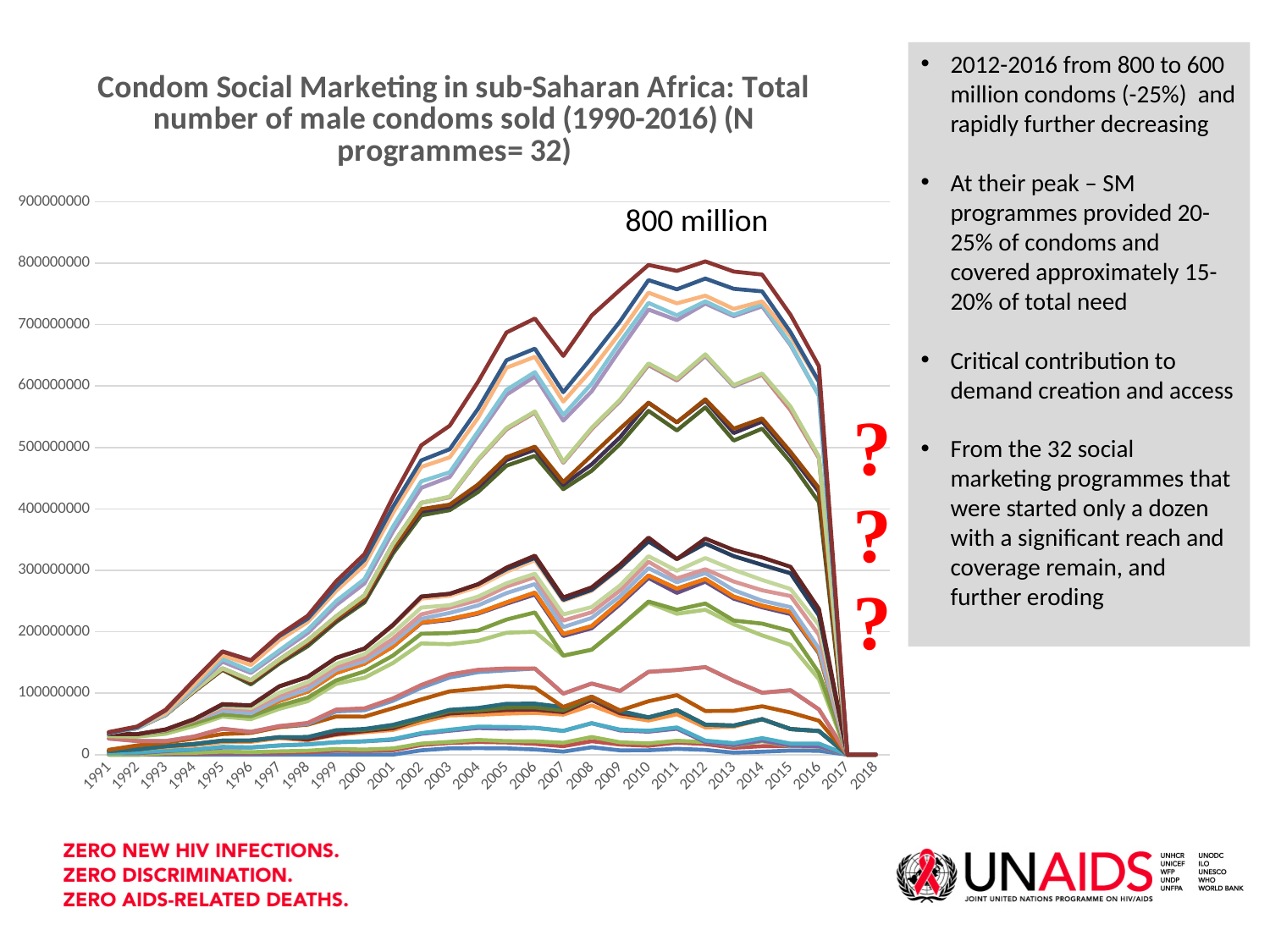
Is the value of the topmost line in 2000 greater or less than 400000000? less What kind of chart is shown on the slide? line chart What is the highest value labelled on the y axis of the chart? 900000000 Is the value of the topmost line in 1991 greater or less than 100000000? less Between 1991 and 2012, does the topmost line generally rise or fall? rise Between 2012 and 2016, does the topmost line rise or fall? fall What text annotation is placed near the peak of the topmost line? 800 million Is the value of the topmost line in 2016 greater or less than 500000000? greater How many years are labelled along the x axis of the chart? 28 What is the title of the chart? Condom Social Marketing in sub-Saharan Africa: Total number of male condoms sold (1990-2016) (N programmes= 32)